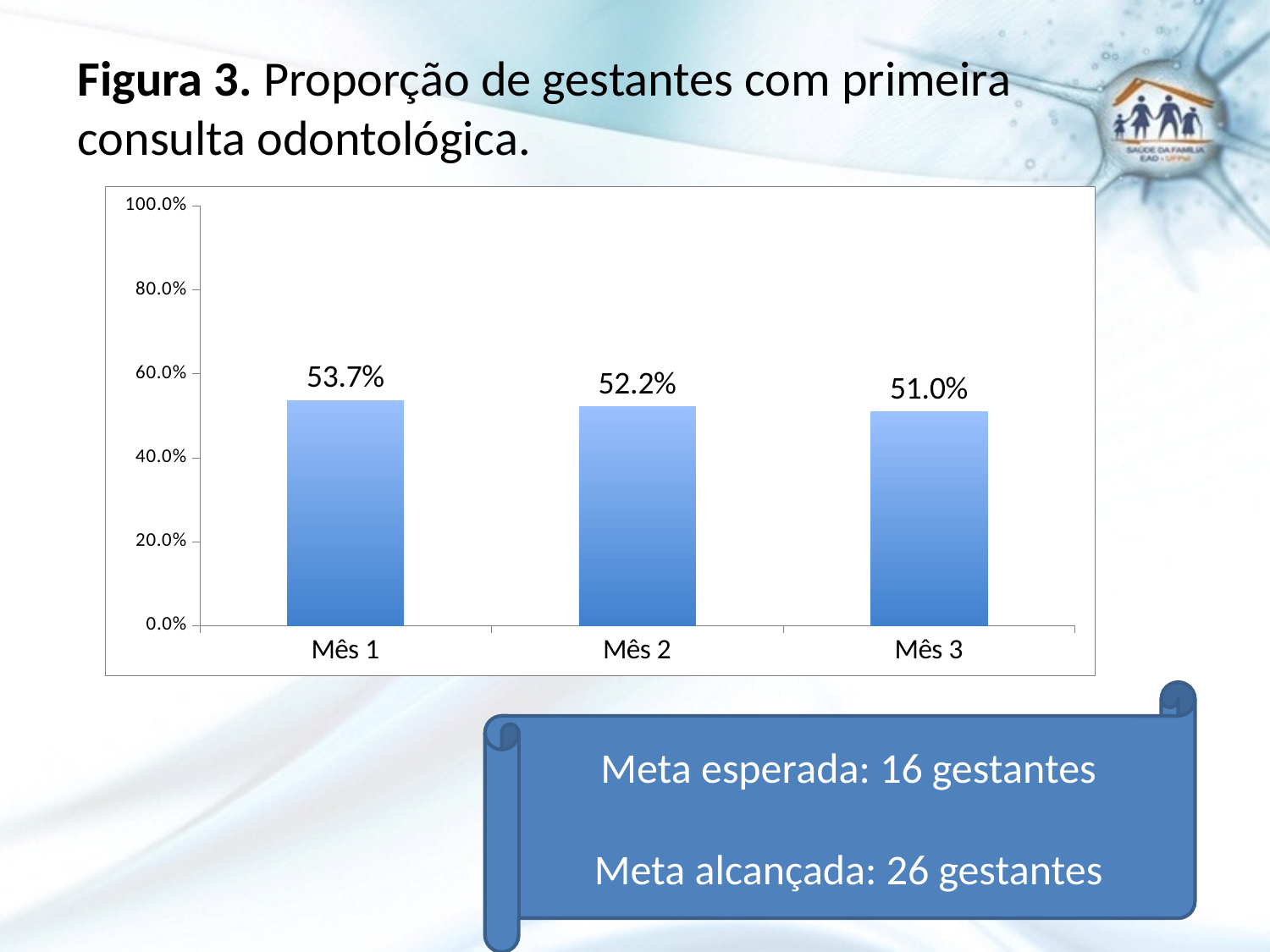
Is the value for Mês 1 greater or less than 60.0%? less What is the difference between the values for Mês 1 and Mês 3? 2.7% Do the values rise or fall from Mês 1 to Mês 3? fall What is the value for Mês 2? 52.2% Which month has the highest value? Mês 1 What is the value for Mês 3? 51.0% What kind of chart is shown on the slide? bar chart What is the difference between the values for Mês 1 and Mês 2? 1.5% What is the value for Mês 1? 53.7% Which is larger, the value for Mês 2 or the value for Mês 3? Mês 2 Which month has the lowest value? Mês 3 How many months are shown on the x axis? 3